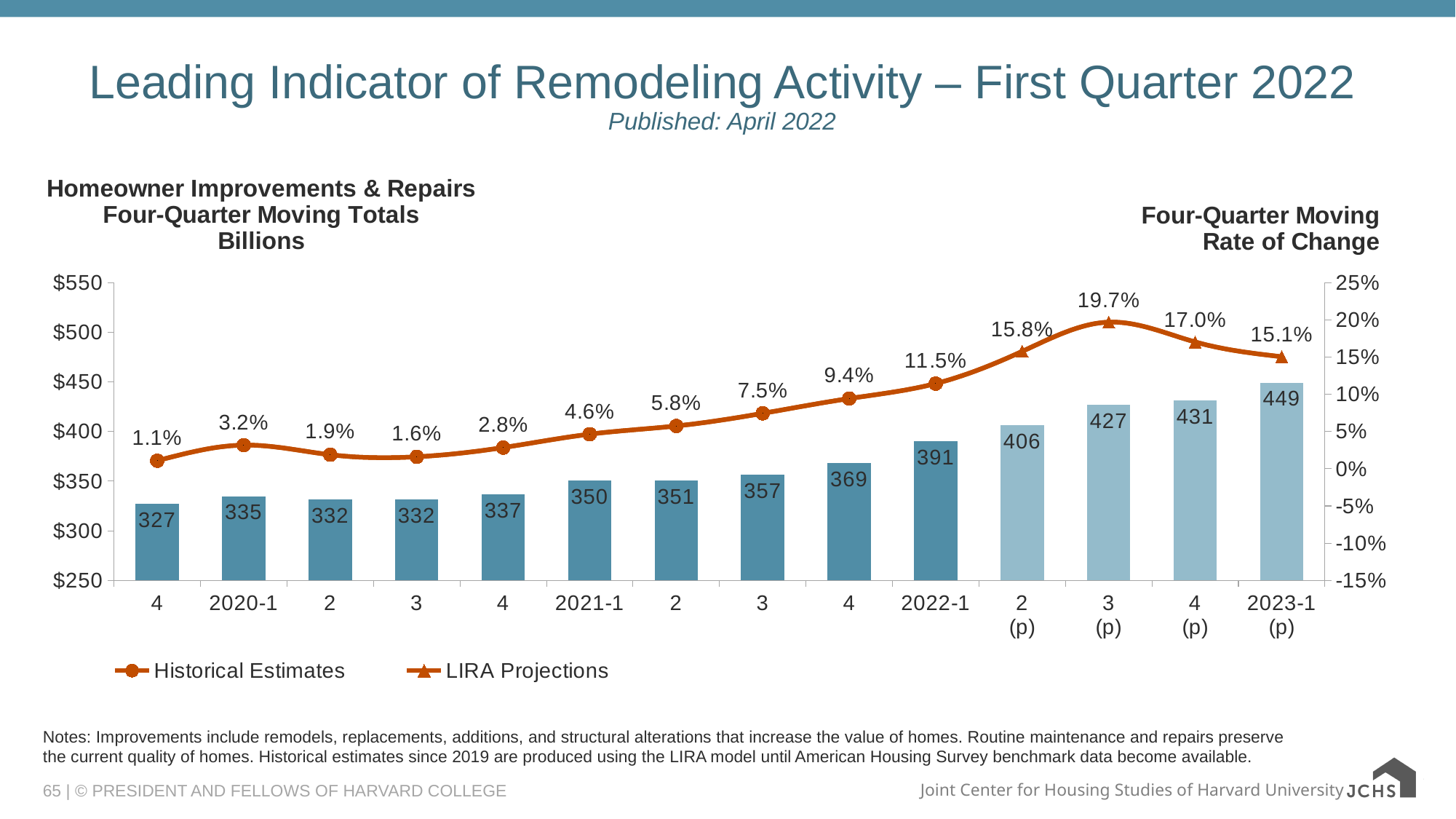
What are the two entries in the chart legend? Historical Estimates and LIRA Projections What is the projected four-quarter moving total for 2023-1 (p)? 449 Which period has the highest four-quarter moving rate of change? 3 (p) (2022) Which is larger, the rate of change for 4 (p) of 2022 or for 2023-1 (p)? 4 (p) of 2022 What is the four-quarter moving rate of change for 2021-1? 4.6% What is the four-quarter moving total (in billions) for 2022-1? 391 What is the difference between the four-quarter moving totals for 2023-1 (p) and 2022-1? 58 How many series does the legend list? 2 Which period has the lowest four-quarter moving total? 4 (2019) How many periods are shown on the x axis? 14 Do the four-quarter moving totals rise or fall from 2021-1 to 2023-1 (p)? Rise What kind of chart is used for the four-quarter moving totals? Bar chart